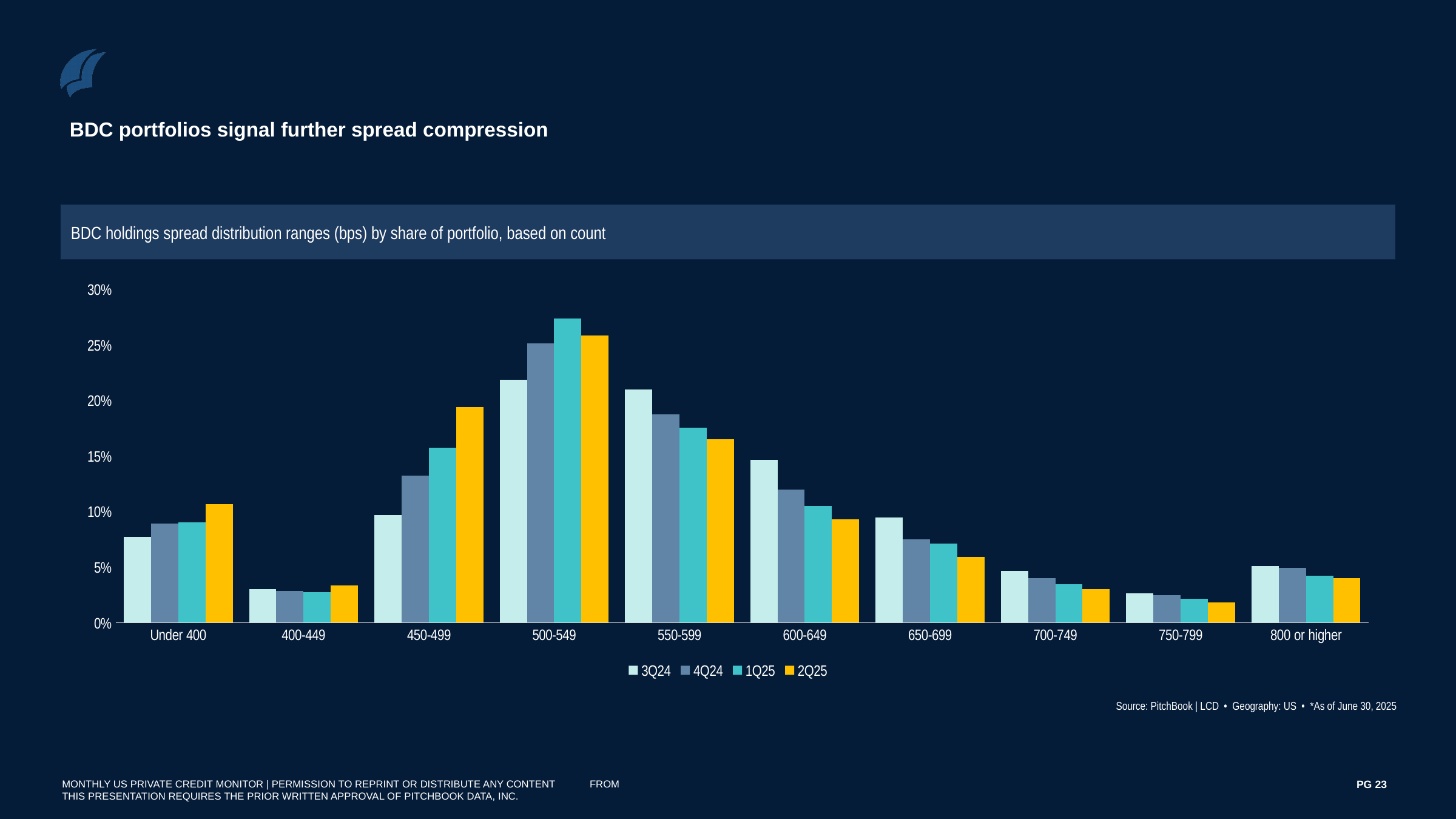
Is the 2Q25 value for 450-499 greater or less than 15%? greater For the 450-499 range, which is larger: the 3Q24 value or the 2Q25 value? 2Q25 How many series does the legend list? 4 Do the 3Q24 values rise or fall along the x axis from 550-599 to 750-799? fall What kind of chart is shown on the slide? Bar chart Which spread range has the lowest 2Q25 share of portfolio? 750-799 Is the 1Q25 value for 500-549 greater or less than 25%? greater What is the title of the chart? BDC holdings spread distribution ranges (bps) by share of portfolio, based on count How many spread ranges are shown on the x axis? 10 Is the 3Q24 value for 600-649 greater or less than 10%? greater For the 550-599 range, which is larger: the 3Q24 value or the 2Q25 value? 3Q24 Which spread range has the highest 2Q25 share of portfolio? 500-549